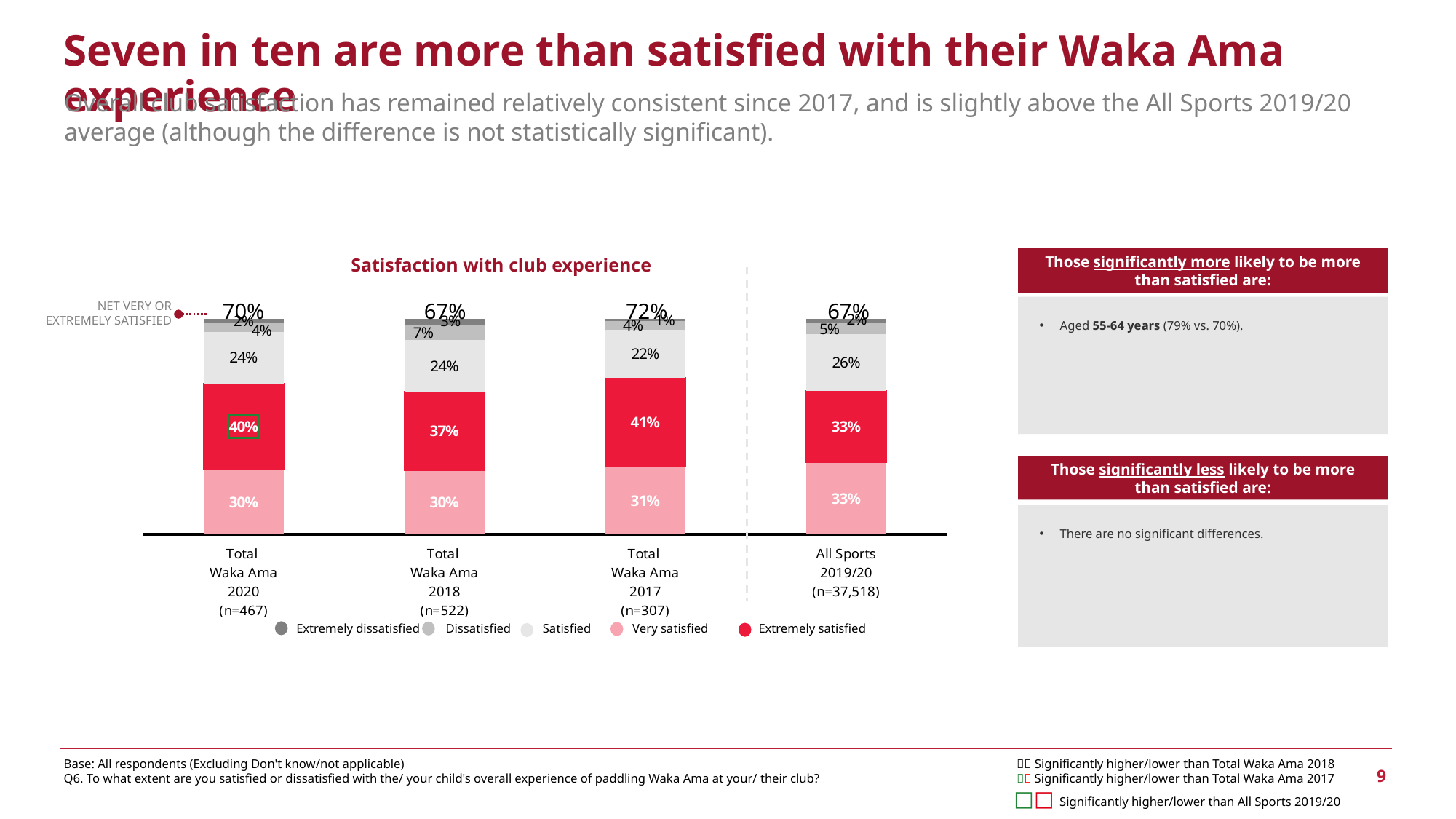
What type of chart is shown on the slide? Stacked bar chart What is the Extremely satisfied value for Total Waka Ama 2020? 40% How many bars are plotted in the chart? 4 What is the net very or extremely satisfied figure for Total Waka Ama 2017? 72% How many series does the legend list? 5 What is the Dissatisfied value for Total Waka Ama 2018? 7% Which is larger, the Satisfied value for Total Waka Ama 2017 or for All Sports 2019/20? All Sports 2019/20 What is the Very satisfied value for All Sports 2019/20? 33% Which bar has the lowest net very or extremely satisfied figure? Total Waka Ama 2018 and All Sports 2019/20 (both 67%) What is the difference between the Extremely satisfied values for Total Waka Ama 2020 and All Sports 2019/20? 7% Which bar has the highest Extremely satisfied value? Total Waka Ama 2017 What is the chart's title? Satisfaction with club experience